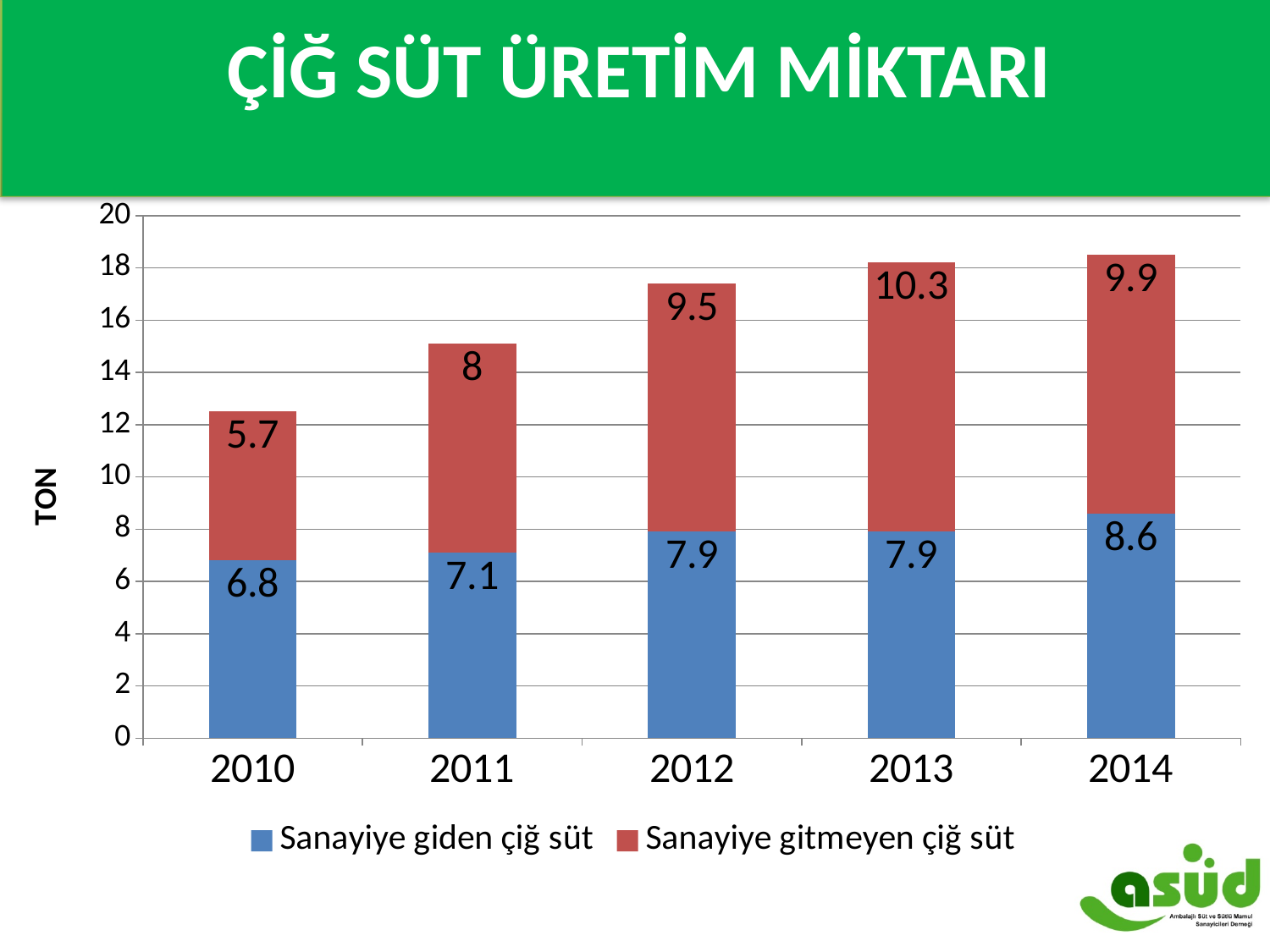
What is the value of Sanayiye gitmeyen çiğ süt for 2013? 10.3 Which year has the highest value for Sanayiye gitmeyen çiğ süt? 2013 What is the total of the stacked bar for 2014? 18.5 What is the total of the stacked bar for 2010? 12.5 Which is larger in 2012: Sanayiye giden çiğ süt or Sanayiye gitmeyen çiğ süt? Sanayiye gitmeyen çiğ süt What is the value of Sanayiye giden çiğ süt for 2010? 6.8 What kind of chart is shown on the slide? Stacked bar chart How many years are shown on the x axis? 5 Which year has the lowest value for Sanayiye giden çiğ süt? 2010 What is the difference between the Sanayiye giden çiğ süt values for 2014 and 2010? 1.8 What is the value of Sanayiye gitmeyen çiğ süt for 2011? 8 How many series does the legend list? 2